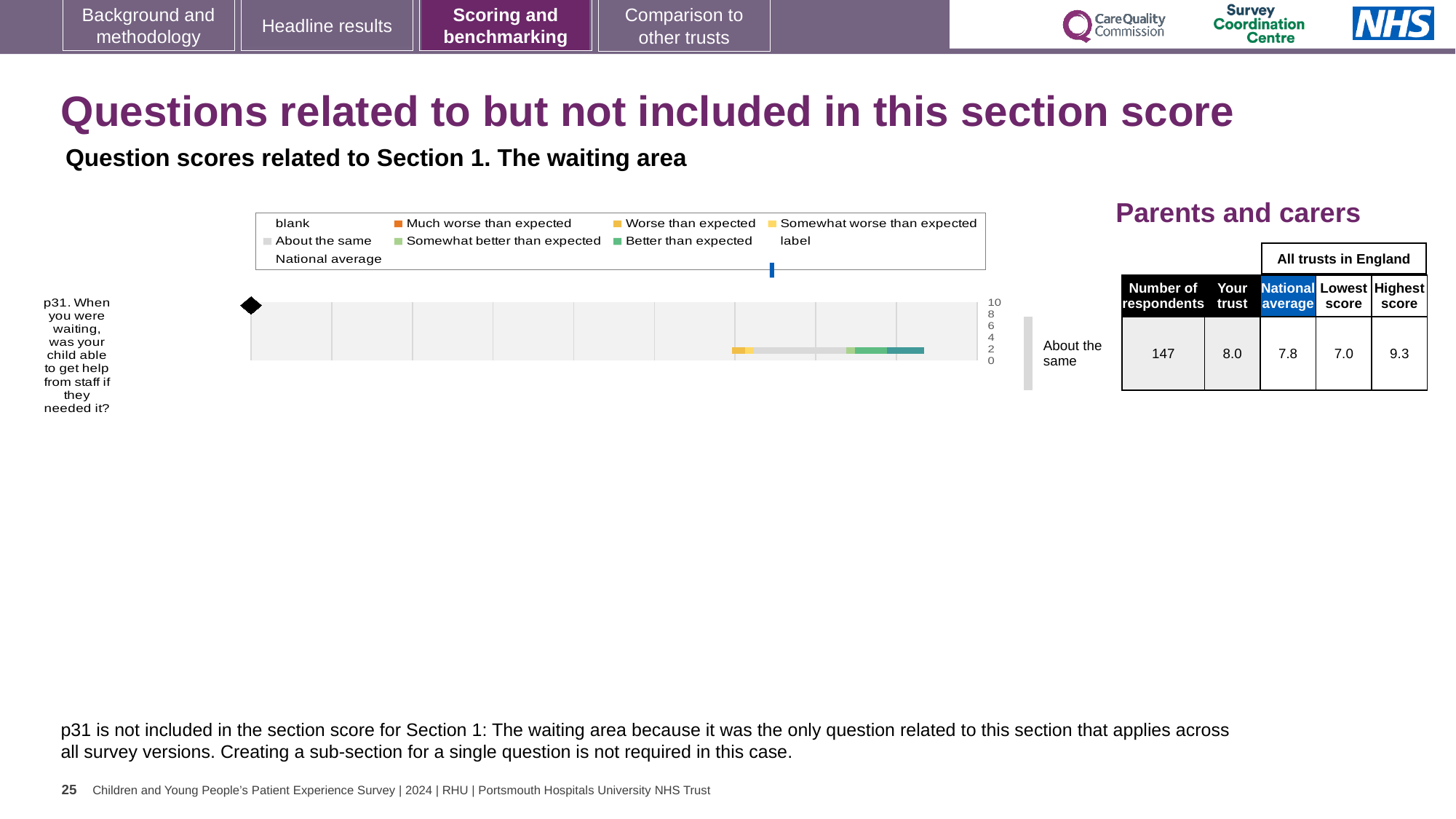
How many survey questions are plotted in the chart? 1 What kind of chart is shown on the slide? bar chart What is the difference between the highest score and the lowest score for p31? 2.3 Which question number is plotted in the chart? p31 By how much does the 'Your trust' score for p31 exceed the national average? 0.2 What is the national average score for p31? 7.8 What is the highest score among all trusts in England for p31? 9.3 What is the 'Your trust' score for p31? 8.0 How many respondents answered p31? 147 What is the lowest score among all trusts in England for p31? 7.0 What rating label is shown to the right of the bar for p31? About the same Which is larger for p31, the 'Your trust' score or the national average? Your trust